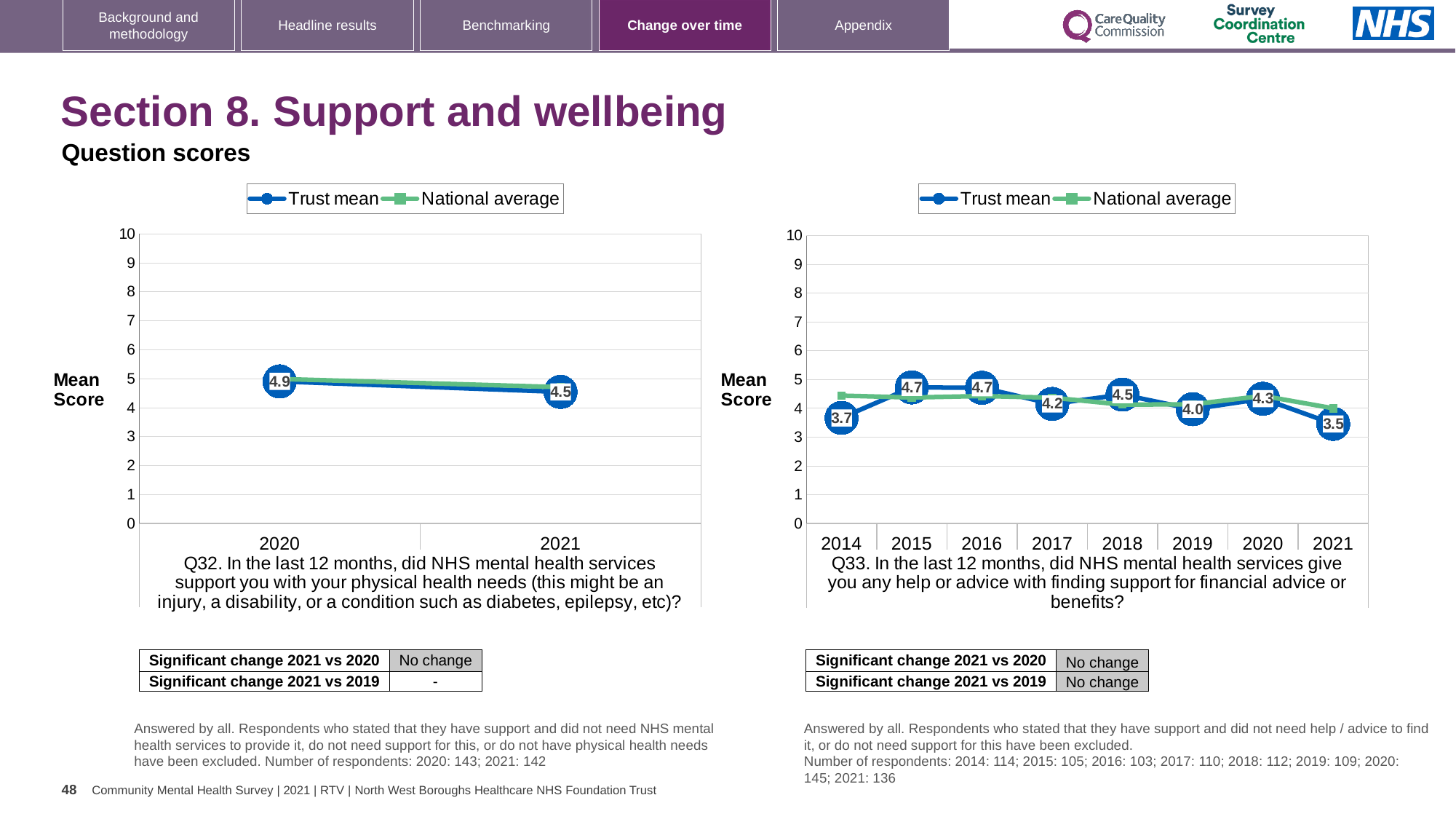
In the Q33 chart on the right, how many years are shown on the x axis? 8 In the Q33 chart on the right, what is the difference between the Trust mean in 2018 and in 2019? 0.5 In the Q32 chart on the left, what is the Trust mean for 2020? 4.9 In the Q32 chart on the left, what is the Trust mean for 2021? 4.5 In the Q33 chart on the right, is the Trust mean for 2015 greater or less than 4? greater In the Q33 chart on the right, is the Trust mean higher in 2017 or in 2020? 2020 What type of chart is the Q33 chart on the right? Line chart In the Q32 chart on the left, how many series does the legend list? 2 In the Q33 chart on the right, which year has the lowest Trust mean? 2021 In the Q33 chart on the right, what is the Trust mean for 2021? 3.5 In the Q33 chart on the right, what is the Trust mean for 2014? 3.7 In the Q32 chart on the left, by how much did the Trust mean fall from 2020 to 2021? 0.4